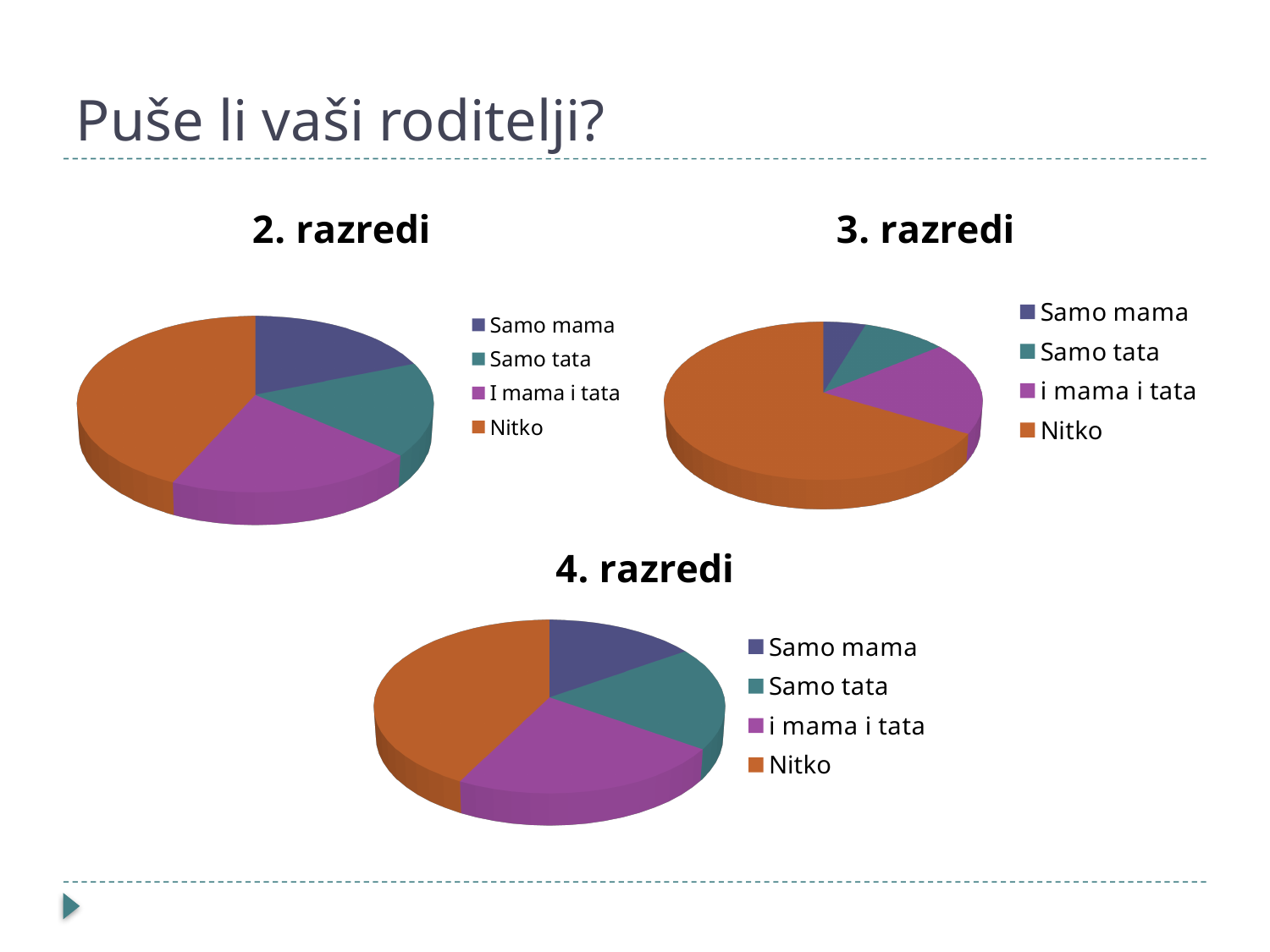
In the "4. razredi" chart, which category has the largest slice? Nitko How many pie charts are on the slide? 3 How many categories does the "4. razredi" chart show? 4 In the "3. razredi" chart, which category has the largest slice? Nitko In the "3. razredi" chart, which category has the smallest slice? Samo mama In the "4. razredi" chart, which is larger: Nitko or Samo mama? Nitko How many categories does the "2. razredi" chart show? 4 In the "2. razredi" chart, which category has the largest slice? Nitko What kind of chart is the "2. razredi" chart? pie chart In the "3. razredi" chart, which is larger: i mama i tata or Samo tata? i mama i tata In the "2. razredi" chart, which is larger: I mama i tata or Samo tata? I mama i tata What is the title of the chart at the bottom of the slide? 4. razredi